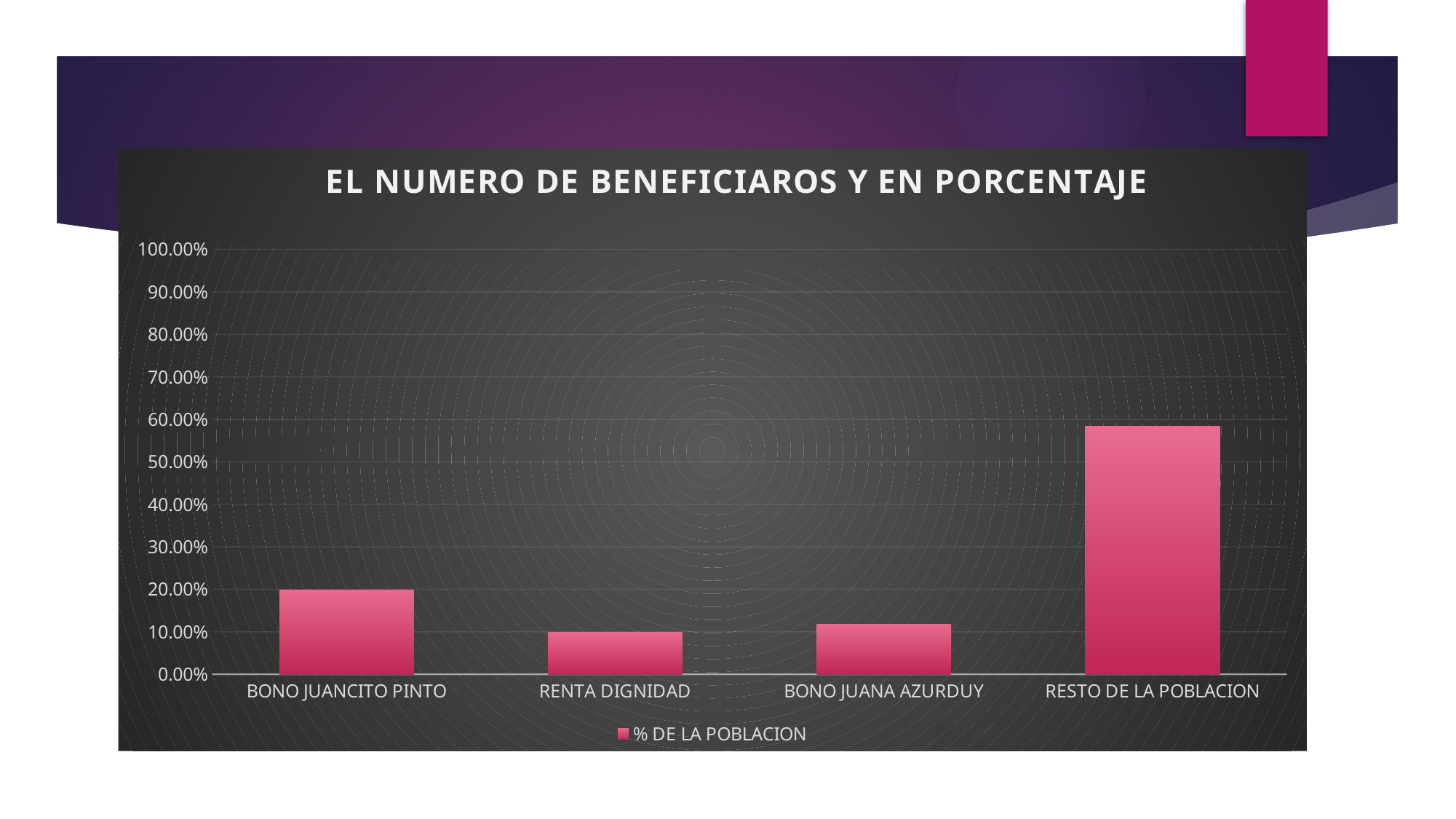
Is the value for BONO JUANA AZURDUY greater or less than 20.00%? less Which category has the highest value? RESTO DE LA POBLACION What is the title of the chart? EL NUMERO DE BENEFICIAROS Y EN PORCENTAJE Which has a larger value, BONO JUANCITO PINTO or BONO JUANA AZURDUY? BONO JUANCITO PINTO How many series does the chart legend list? 1 What type of chart is shown on the slide? Bar chart How many categories are shown on the x axis of the chart? 4 Is the value for BONO JUANCITO PINTO greater or less than 30.00%? less Which category has the lowest value? RENTA DIGNIDAD Is the value for RESTO DE LA POBLACION greater or less than 50.00%? greater What is the name of the series shown in the legend? % DE LA POBLACION